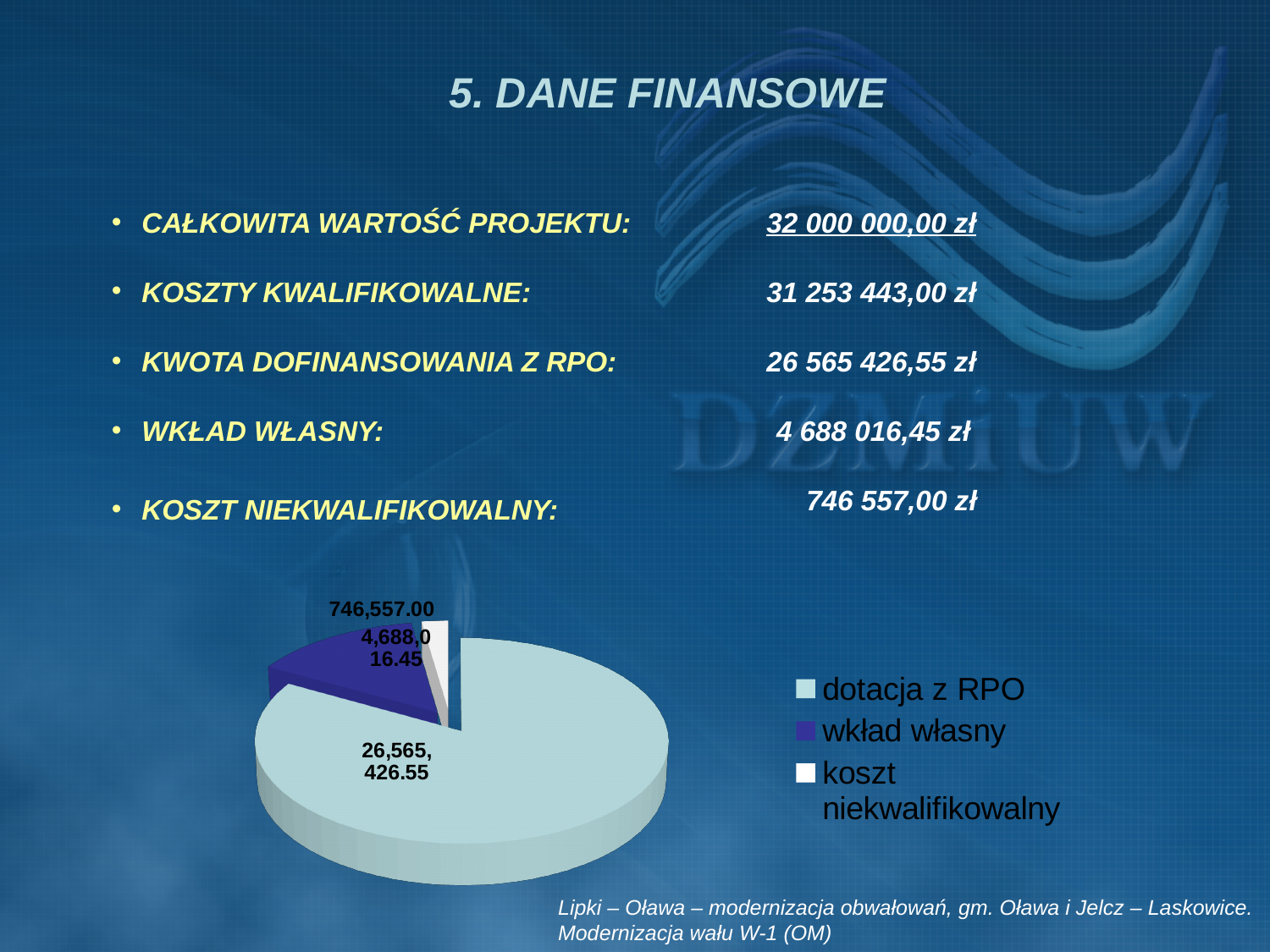
What value is shown for the 'wkład własny' slice of the pie chart? 4,688,016.45 Which is larger in the pie chart, 'wkład własny' or 'koszt niekwalifikowalny'? wkład własny Which legend entry of the pie chart is shown in dark blue? wkład własny What value is shown for the 'koszt niekwalifikowalny' slice of the pie chart? 746,557.00 Which slice of the pie chart is the largest? dotacja z RPO What kind of chart is shown on the slide? pie chart Which slice of the pie chart is the smallest? koszt niekwalifikowalny How many slices does the pie chart have? 3 How many entries does the pie chart's legend list? 3 What is the difference between the 'dotacja z RPO' and 'wkład własny' values in the pie chart? 21,877,410.10 What is the difference between the 'wkład własny' and 'koszt niekwalifikowalny' values in the pie chart? 3,941,459.45 What value is shown for the 'dotacja z RPO' slice of the pie chart? 26,565,426.55